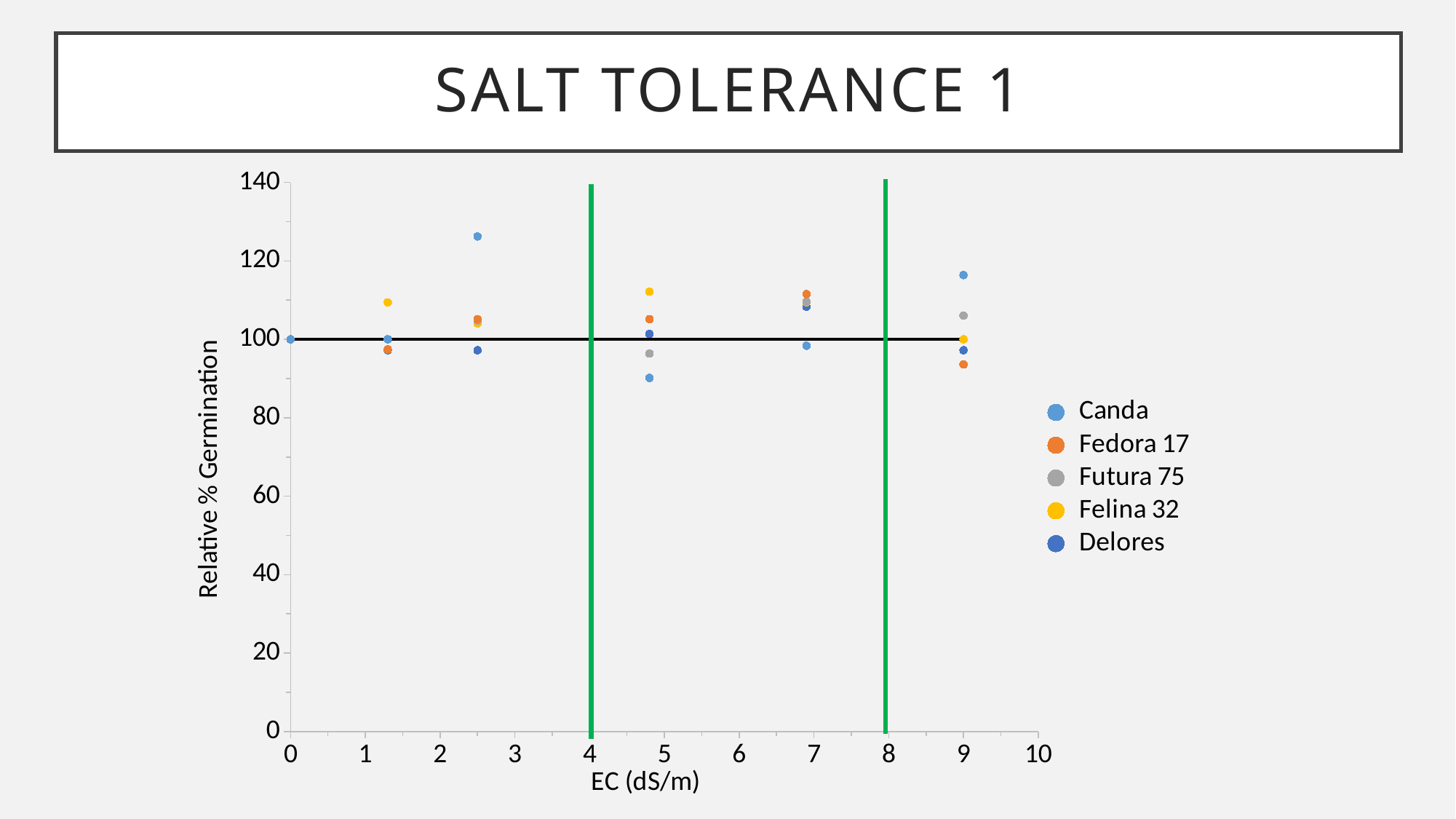
Is the value for Canda at EC 9 greater or less than 100? greater What kind of chart is shown on the slide? scatter chart Is the value for Canda at EC 2.5 greater or less than 120? greater Is the value for Canda at EC 4.8 greater or less than 100? less What is the label of the vertical axis? Relative % Germination How many series does the legend list? 5 At EC 9, which is larger: the value for Canda or the value for Fedora 17? Canda Which series has the lowest point on the chart? Canda What is the title of the chart? SALT TOLERANCE 1 Which series has the highest point on the chart? Canda